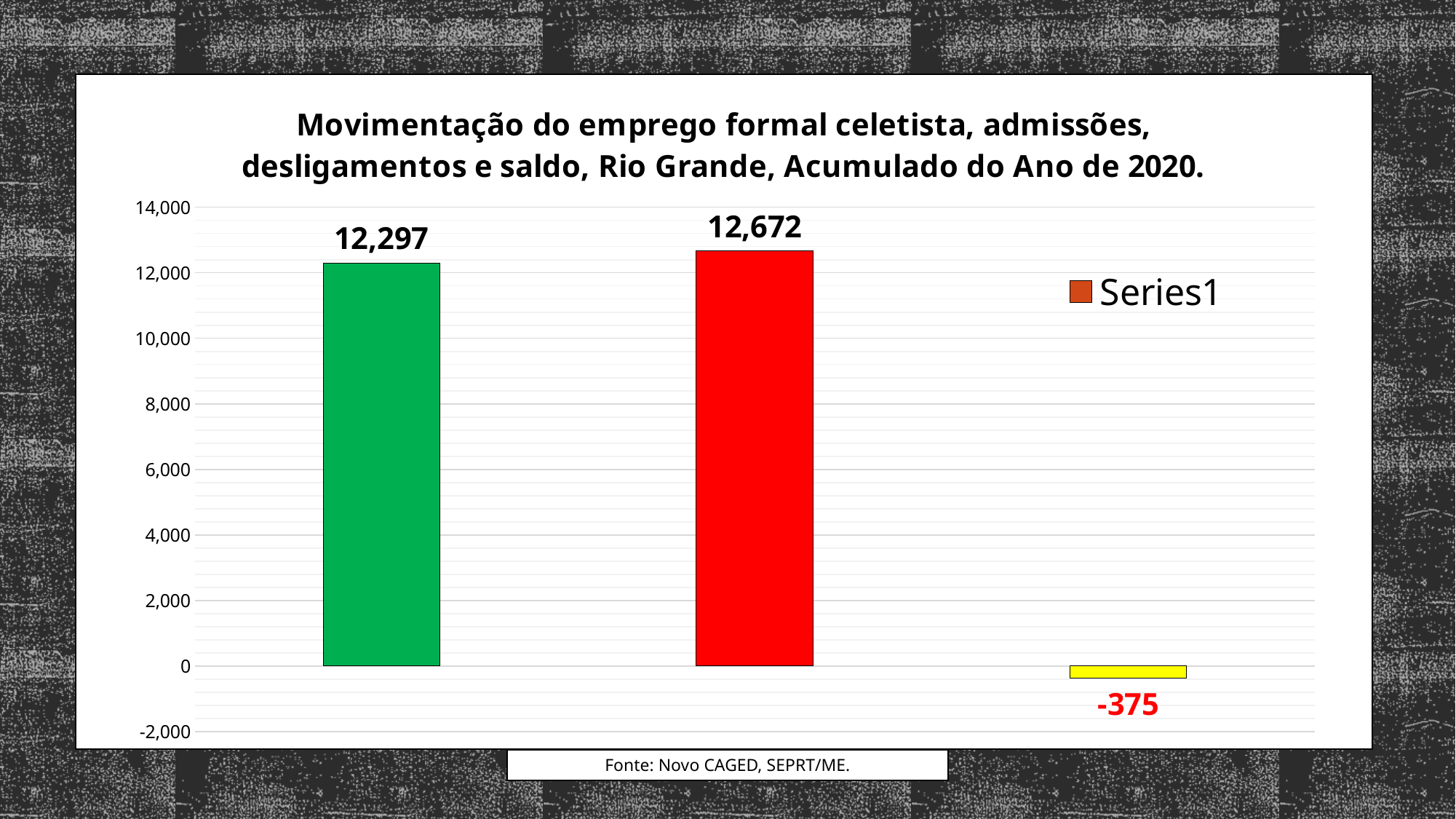
What is the difference between the red bar's value and the green bar's value? 375 What source is cited below the chart? Fonte: Novo CAGED, SEPRT/ME. What is the value shown on the green bar? 12,297 Which is larger, the value of the green bar or the value of the red bar? the red bar Which bar has the lowest value: the green, red or yellow one? yellow Which bar has the highest value: the green, red or yellow one? red Is the value of the green bar greater or less than 12,000? greater What kind of chart is shown on the slide? bar chart How many bars are plotted in the chart? 3 How many series does the legend list? 1 What is the value shown on the red bar? 12,672 What is the value shown on the yellow bar? -375